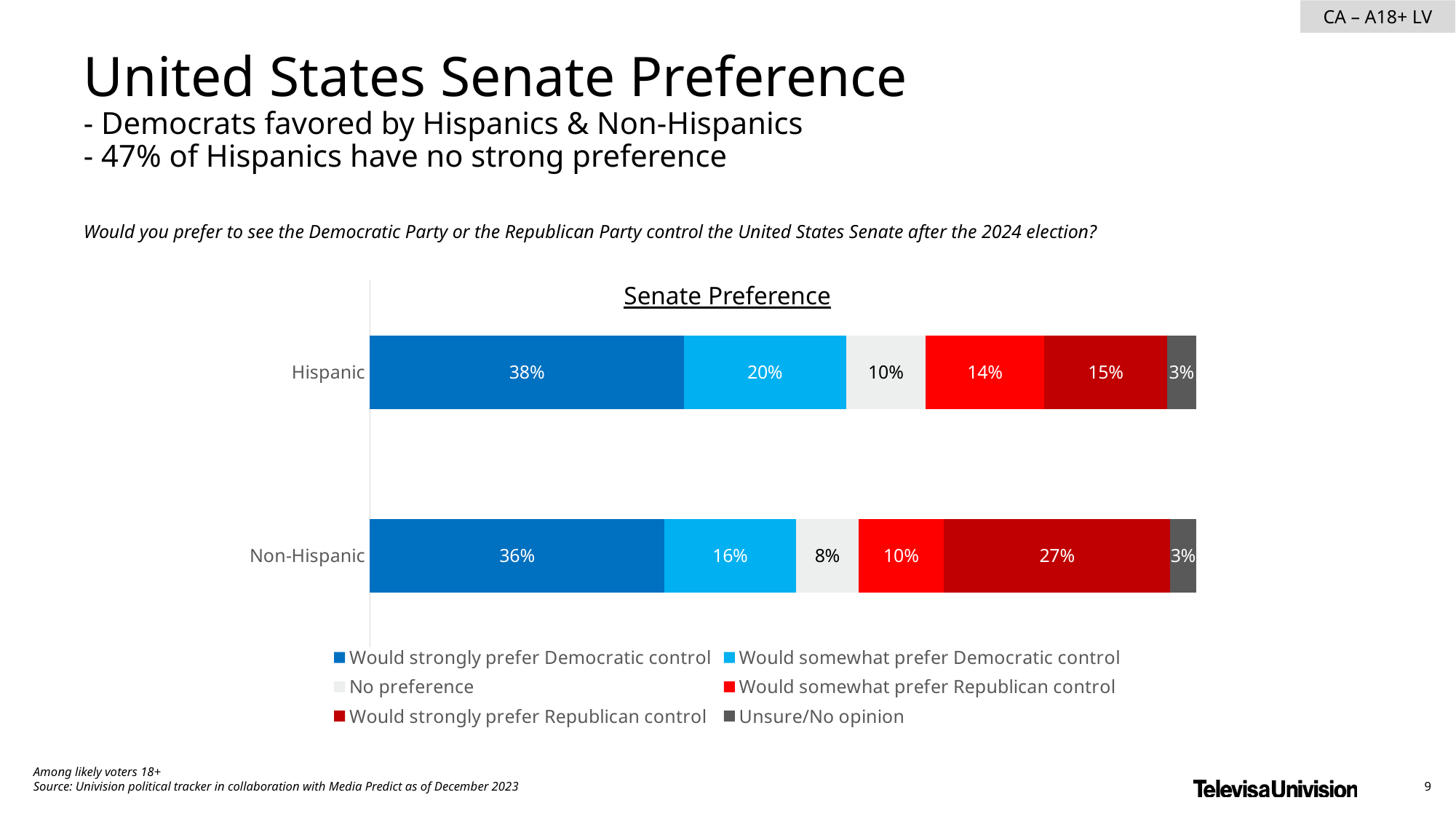
Which response category has the smallest share among Non-Hispanic respondents? Unsure/No opinion How many groups (categories) are shown on the chart? 2 What percentage of Non-Hispanic likely voters would strongly prefer Republican control of the Senate? 27% What percentage of Hispanic likely voters would strongly prefer Democratic control of the Senate? 38% What percentage of Non-Hispanic respondents would somewhat prefer Democratic control? 16% Which response category has the largest share among Hispanic respondents? Would strongly prefer Democratic control What kind of chart is shown on the slide? Stacked bar chart What is the title of the chart? Senate Preference Which group has the higher share that would strongly prefer Republican control, Hispanic or Non-Hispanic? Non-Hispanic What share of Hispanic respondents said they have no preference? 10% What is the difference between the Hispanic and Non-Hispanic shares that would somewhat prefer Republican control? 4% How many series does the legend list? 6